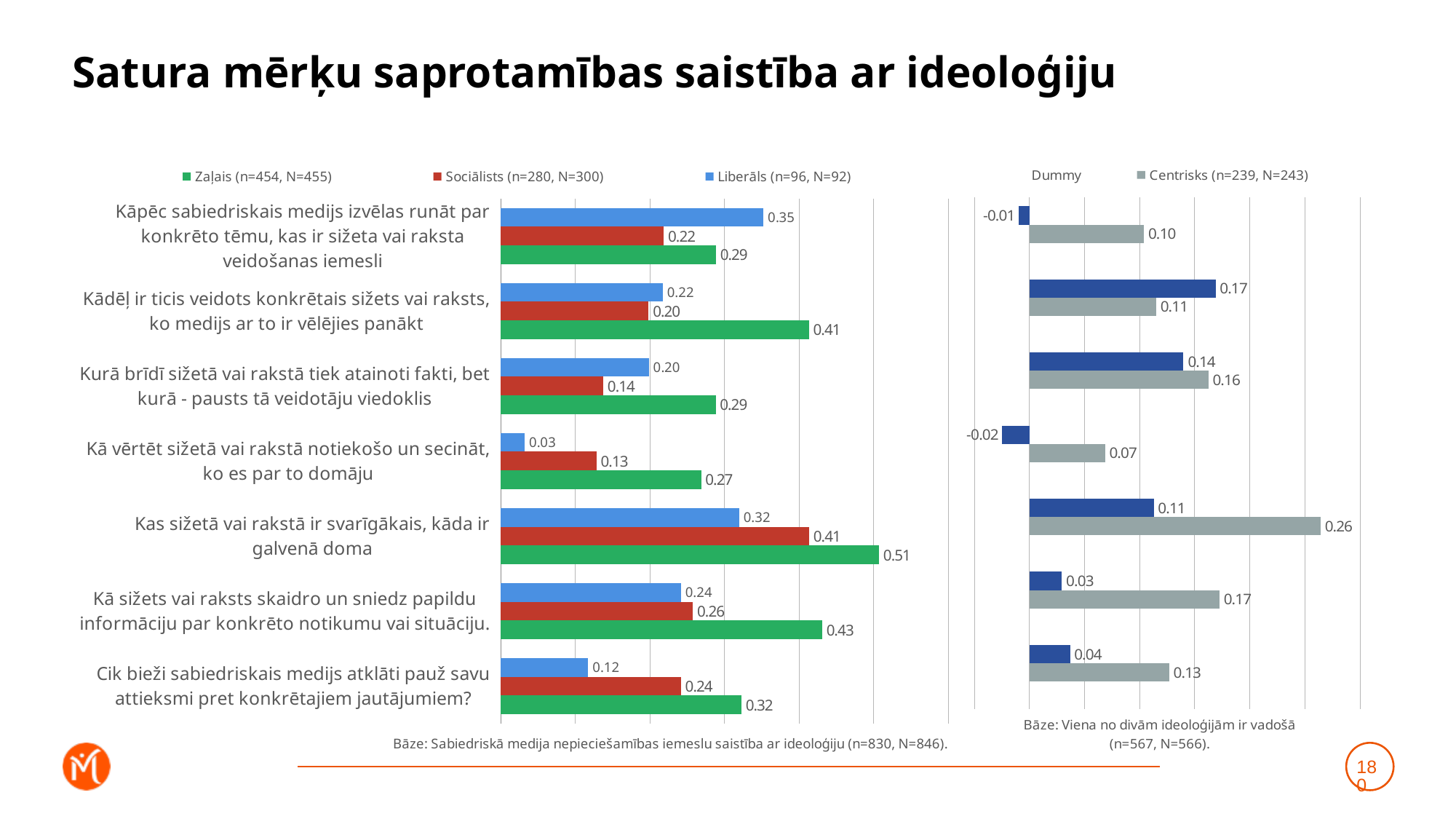
In the left chart, what is the value for Zaļais for "Kas sižetā vai rakstā ir svarīgākais, kāda ir galvenā doma"? 0.51 In the right chart, what is the value for Centrisks for "Kas sižetā vai rakstā ir svarīgākais, kāda ir galvenā doma"? 0.26 How many series does the legend of the left chart list? 3 In the left chart, what is the difference between the Zaļais and Liberāls values for "Kādēļ ir ticis veidots konkrētais sižets vai raksts, ko medijs ar to ir vēlējies panākt"? 0.19 In the left chart, which category has the highest value for Sociālists? Kas sižetā vai rakstā ir svarīgākais, kāda ir galvenā doma How many categories does the left chart show? 7 In the left chart, which is larger for "Cik bieži sabiedriskais medijs atklāti pauž savu attieksmi pret konkrētajiem jautājumiem?": Sociālists or Liberāls? Sociālists What kind of chart is the right chart? Bar chart In the left chart, what is the value for Liberāls for "Kā vērtēt sižetā vai rakstā notiekošo un secināt, ko es par to domāju"? 0.03